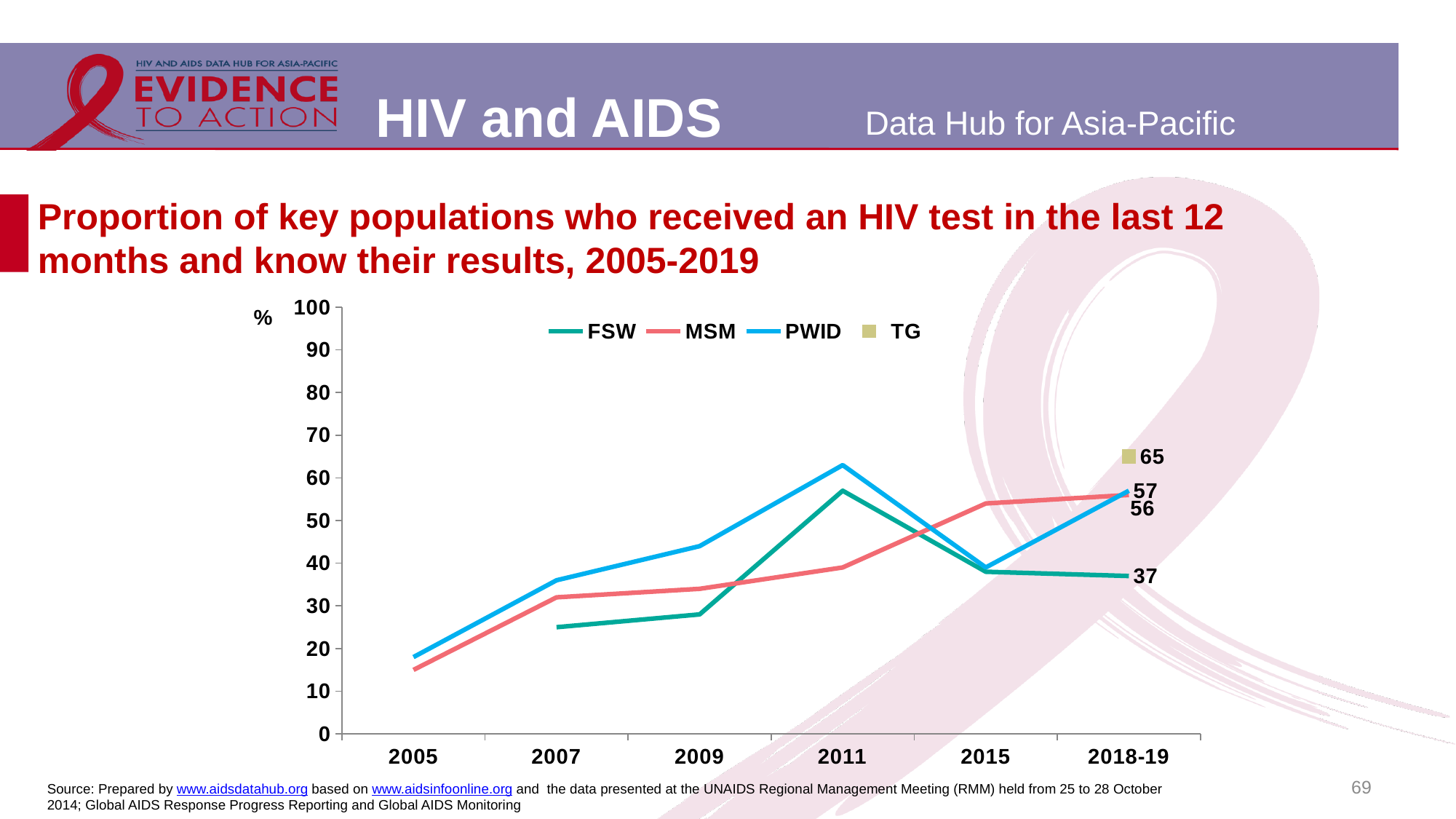
Is the value for PWID in 2011 greater or less than 60? greater What is the value for FSW in 2018-19? 37 What kind of chart is shown on the slide? Line chart Is the value for MSM in 2005 greater or less than 20? less How many time periods are shown on the x axis? 6 What is the value for TG in 2018-19? 65 Which key population has the highest value in 2018-19? TG What is the difference between the TG and FSW values in 2018-19? 28 What is the value for PWID in 2018-19? 57 In 2018-19, which is larger: the value for TG or the value for FSW? TG Which key population has the lowest value in 2018-19? FSW How many series does the legend list? 4